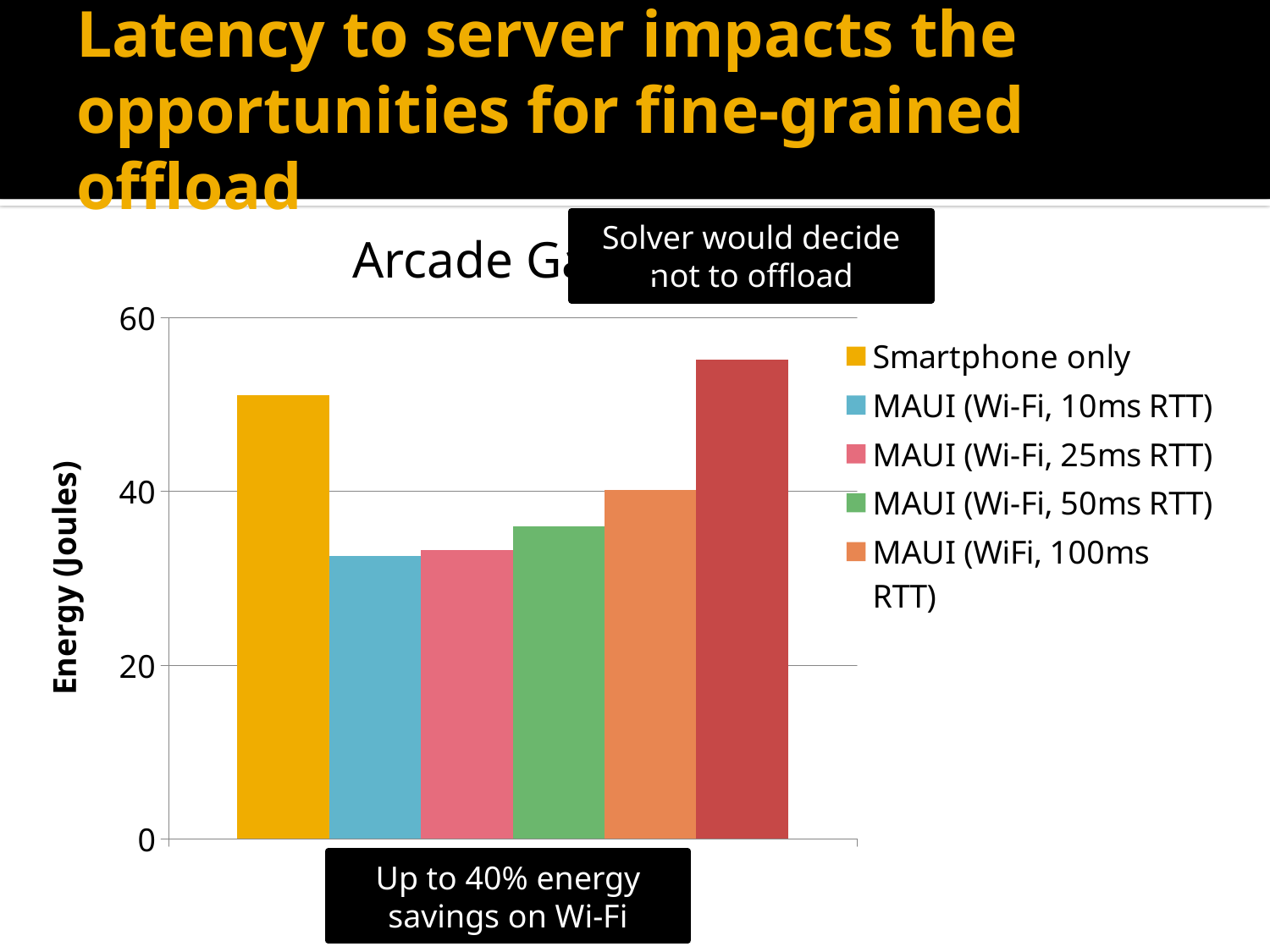
Is the value for MAUI (Wi-Fi, 25ms RTT) greater or less than 20? greater What is the label of the vertical axis of the chart? Energy (Joules) How many series does the chart's legend list? 5 Is the value for Smartphone only greater or less than 40? greater What colour is the bar for Smartphone only? yellow What kind of chart is shown on the slide? bar chart Which is larger, the value for Smartphone only or the value for MAUI (Wi-Fi, 10ms RTT)? Smartphone only How many bars are plotted in the chart? 6 Is the value for MAUI (Wi-Fi, 10ms RTT) greater or less than 40? less Do the MAUI values rise or fall as the RTT increases from 10ms to 100ms? rise Which is larger, the value for MAUI (Wi-Fi, 50ms RTT) or the value for MAUI (Wi-Fi, 10ms RTT)? MAUI (Wi-Fi, 50ms RTT)